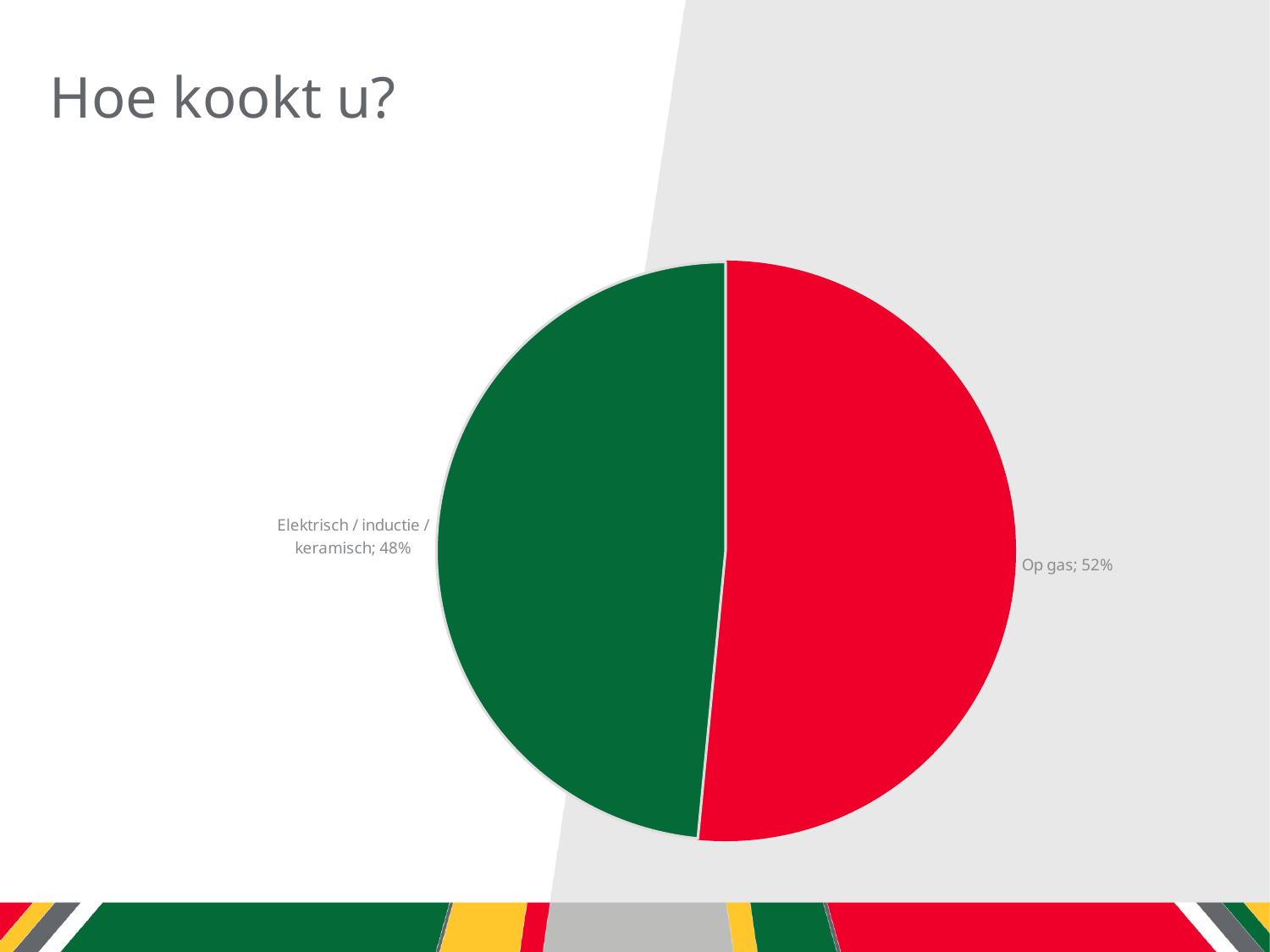
Which category has the largest slice of the pie? Op gas What colour is the "Op gas" slice? Red What share of the pie is labelled "Op gas"? 52% How many slices does the pie chart have? 2 What share of the pie is labelled "Elektrisch / inductie / keramisch"? 48% Which category has the smallest slice of the pie? Elektrisch / inductie / keramisch What is the difference in percentage points between the "Op gas" slice and the "Elektrisch / inductie / keramisch" slice? 4 percentage points Is the share for "Op gas" greater or less than 50%? greater Which is larger: the "Op gas" slice or the "Elektrisch / inductie / keramisch" slice? Op gas What is the title of the slide? Hoe kookt u? What kind of chart is shown on the slide? Pie chart